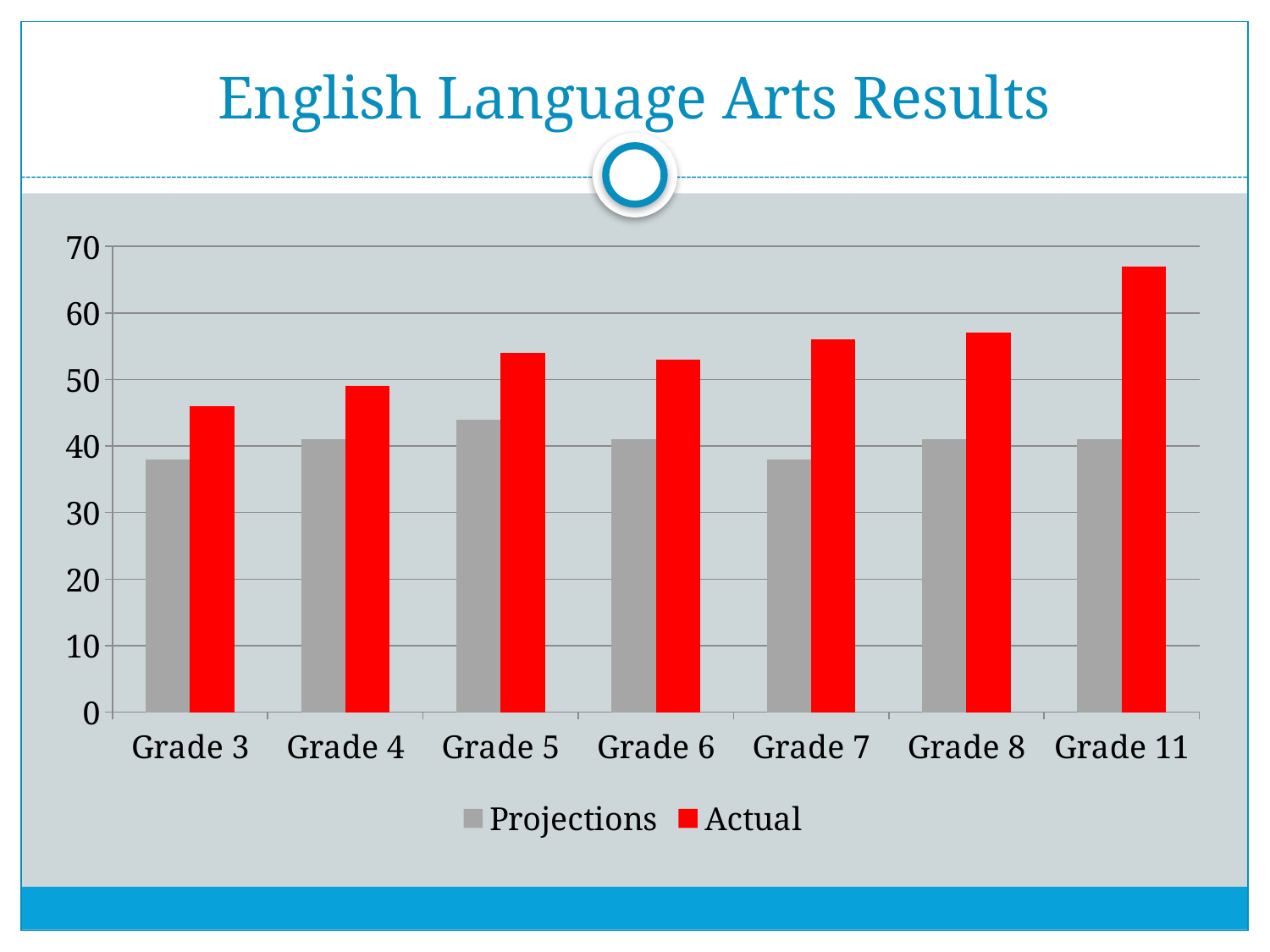
Which grade has the highest Projections value? Grade 5 What kind of chart is shown on the slide? Bar chart Which grade has the highest Actual value? Grade 11 Which colour represents the Actual series in the legend? Red Is the Projections value for Grade 3 greater or less than 40? less Is the Actual value for Grade 11 greater or less than 60? greater How many grade categories are shown on the x axis? 7 For Grade 7, which is larger, Projections or Actual? Actual How many series does the legend list? 2 Is the Actual value for Grade 3 greater or less than 50? less Which grade has the lowest Actual value? Grade 3 What is the title of the chart? English Language Arts Results